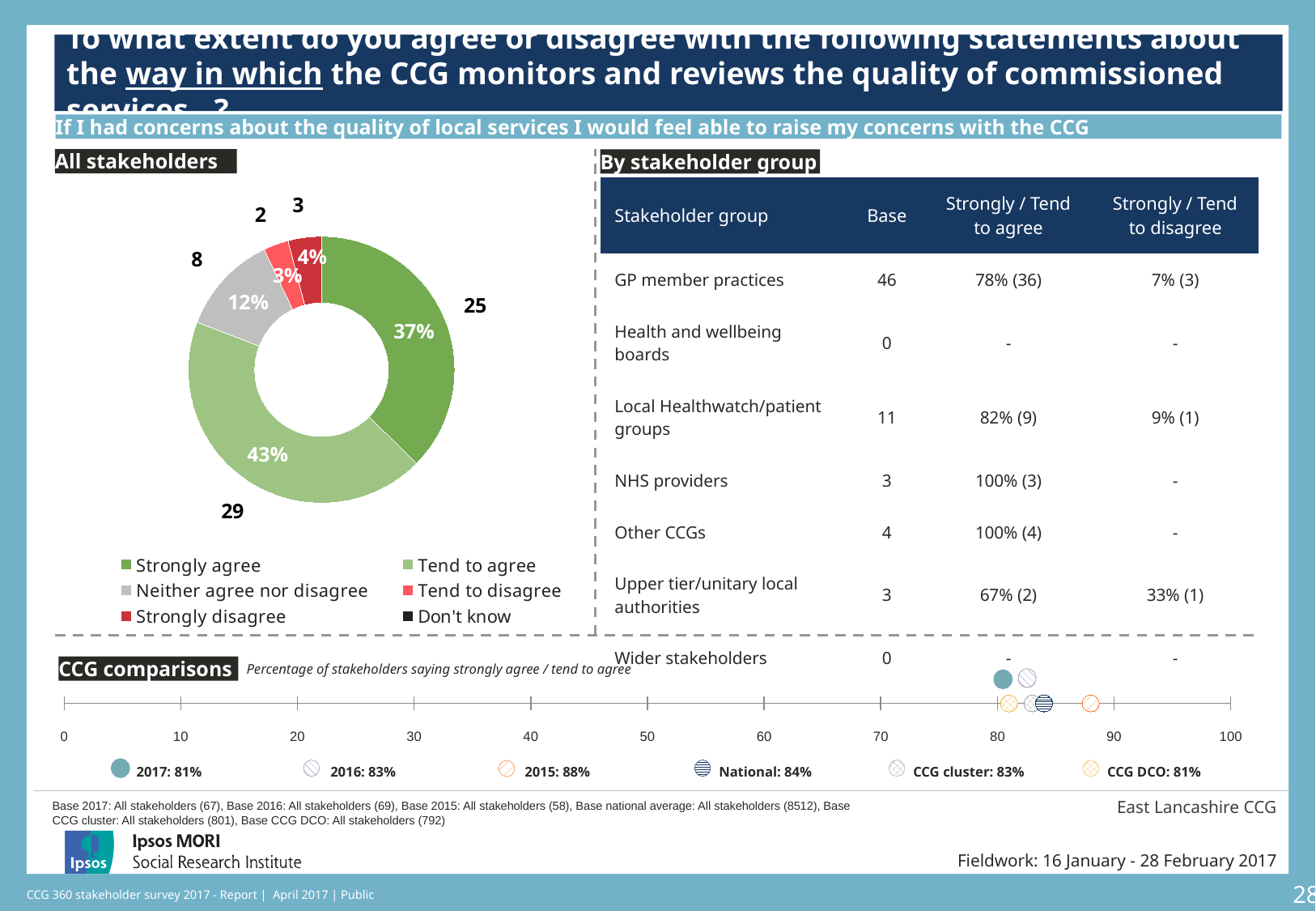
In the 'CCG comparisons' chart, what is the 2017 percentage of stakeholders saying strongly agree / tend to agree? 81% In the 'All stakeholders' donut chart, how many stakeholders (count) said 'Strongly agree'? 25 In the 'All stakeholders' donut chart, what percentage of stakeholders said 'Tend to agree'? 43% In the 'CCG comparisons' chart, what is the difference between the National value and the 2017 value? 3 percentage points In the 'All stakeholders' donut chart, which response category has the largest share? Tend to agree In the 'All stakeholders' donut chart, what is the difference in percentage points between 'Tend to agree' and 'Strongly agree'? 6 In the 'CCG comparisons' chart, which comparison point has the highest value? 2015: 88% How many entries does the legend of the 'All stakeholders' chart list? 6 What type of chart is the 'All stakeholders' chart? Donut chart In the 'All stakeholders' donut chart, what percentage said 'Neither agree nor disagree'? 12% In the 'All stakeholders' donut chart, what percentage of stakeholders said 'Strongly agree'? 37% In the 'All stakeholders' donut chart, which is larger: the share for 'Strongly disagree' or 'Tend to disagree'? Strongly disagree